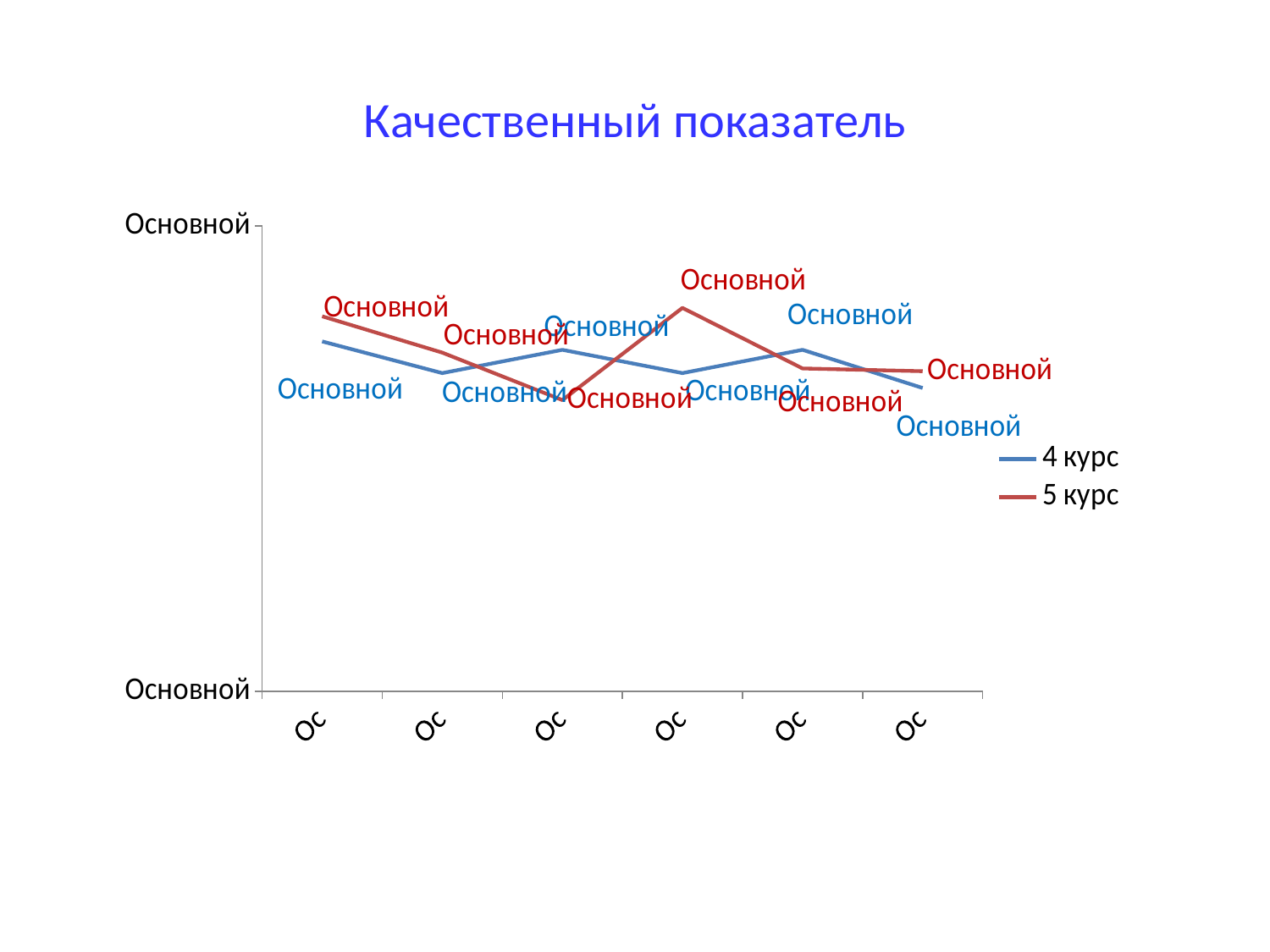
At the fourth point from the left, which series is higher, 4 курс or 5 курс? 5 курс What kind of chart is shown on the slide? line chart What is the title of the chart? Качественный показатель How many data points does each line have? 6 Does the 4 курс line end higher or lower than it starts? lower At which point from the left does the 5 курс line reach its lowest value? the third point How many series does the legend list? 2 At which point from the left does the 5 курс line reach its highest value? the fourth point At the third point from the left, which series is higher, 4 курс or 5 курс? 4 курс Does the 5 курс line end higher or lower than it starts? lower At the first point on the left, which series is higher, 4 курс or 5 курс? 5 курс What are the two series named in the legend? 4 курс and 5 курс